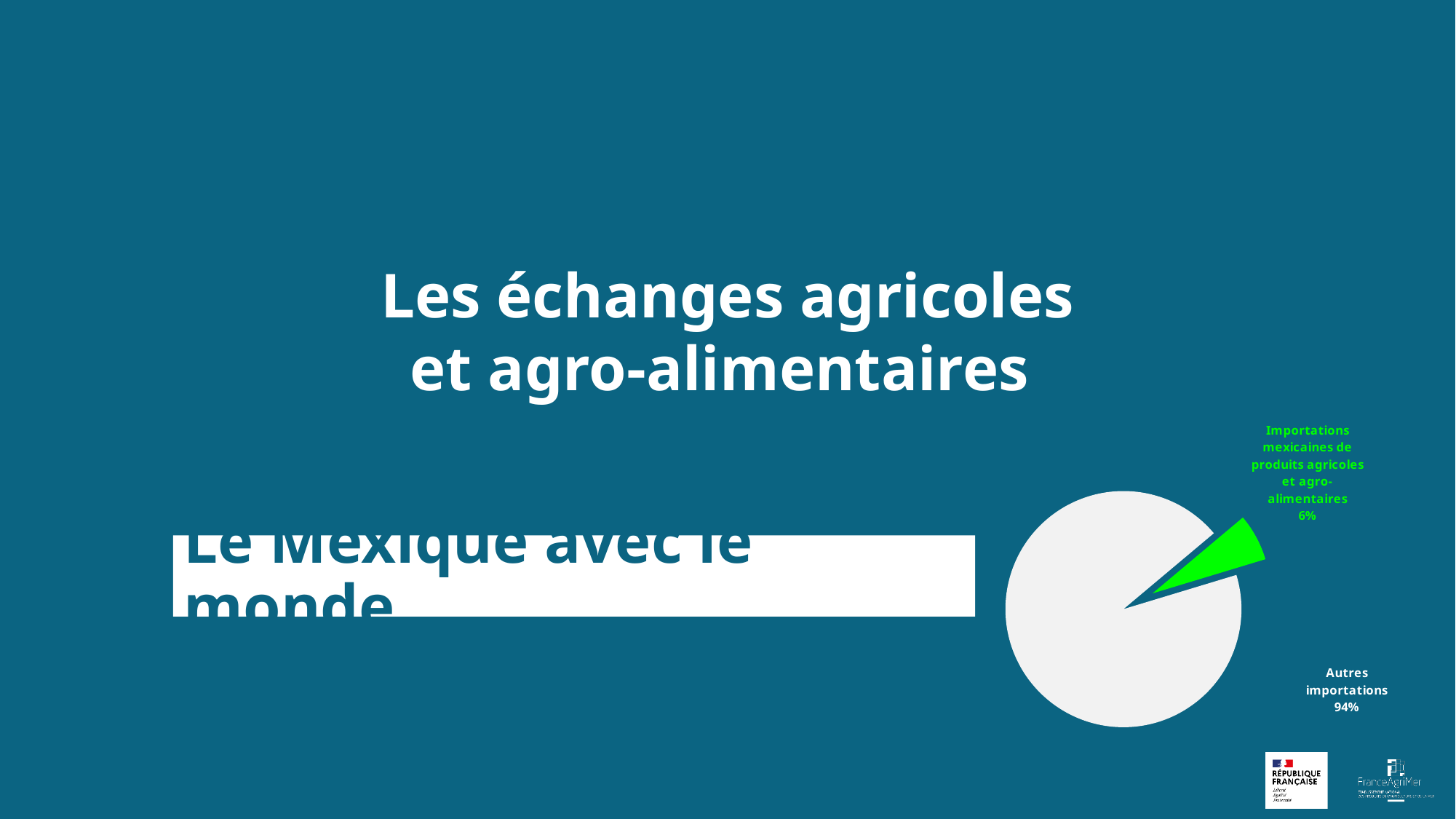
What kind of chart is shown on the slide? pie chart Which is larger: the "Autres importations" slice or the "Importations mexicaines de produits agricoles et agro-alimentaires" slice? Autres importations What is the total of the two slice percentages shown on the pie chart? 100% Which slice of the pie chart is the largest? Autres importations What colour is the "Importations mexicaines de produits agricoles et agro-alimentaires" slice? green What share of the pie is labelled "Importations mexicaines de produits agricoles et agro-alimentaires"? 6% How many slices does the pie chart have? 2 What is the difference in percentage points between the "Autres importations" slice and the "Importations mexicaines de produits agricoles et agro-alimentaires" slice? 88 percentage points What colour is the "Autres importations" slice? light grey What share of the pie is labelled "Autres importations"? 94% Which slice of the pie chart is the smallest? Importations mexicaines de produits agricoles et agro-alimentaires